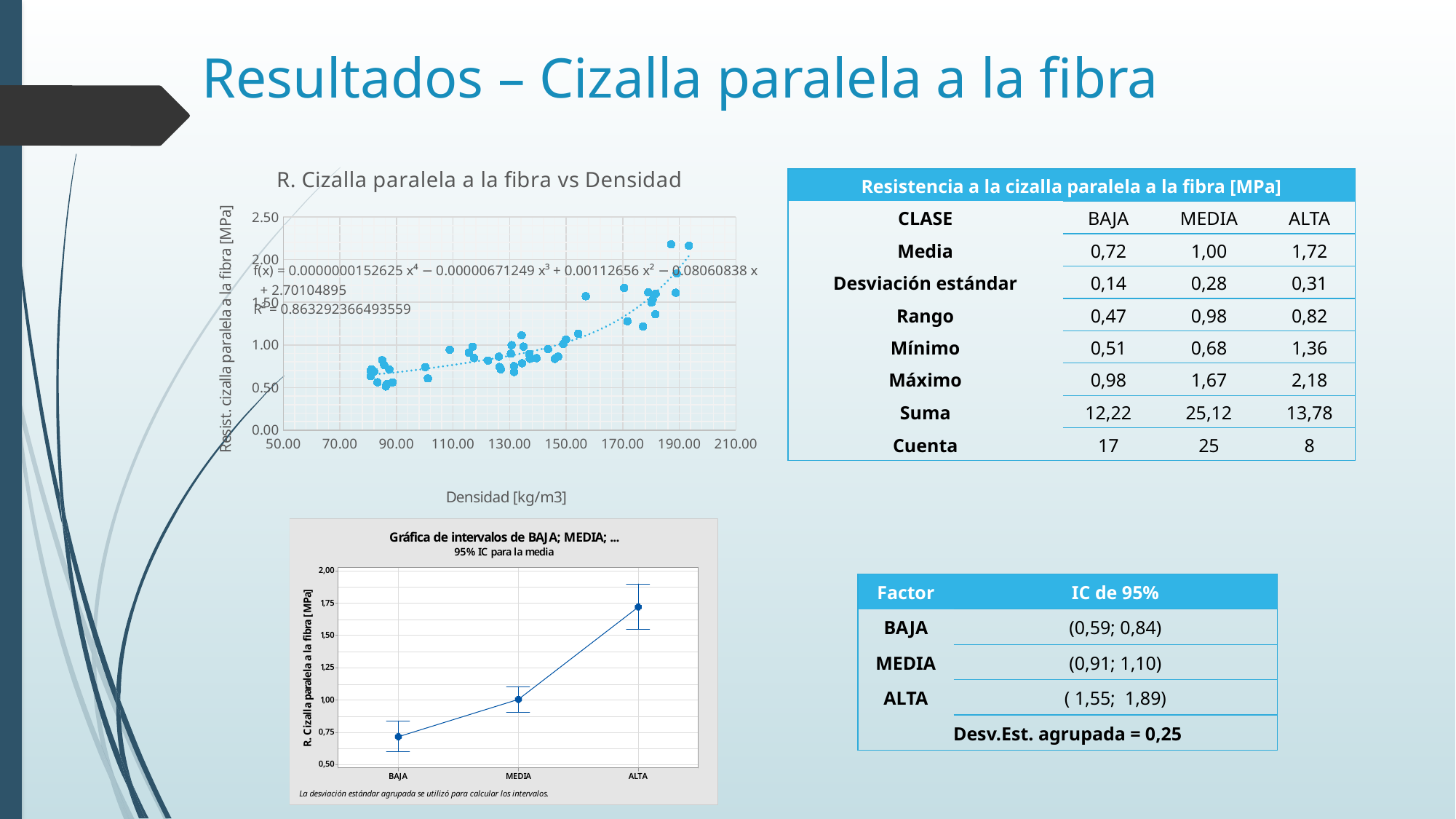
What is the R² value printed on the chart 'R. Cizalla paralela a la fibra vs Densidad'? 0.863292366493559 In the chart 'R. Cizalla paralela a la fibra vs Densidad', do the values generally rise or fall as density increases along the x axis? rise How many categories are shown on the x axis of the chart 'Gráfica de intervalos de BAJA; MEDIA; ...'? 3 In the chart 'R. Cizalla paralela a la fibra vs Densidad', what is the maximum value shown on the y axis? 2.50 In the chart 'Gráfica de intervalos de BAJA; MEDIA; ...', do the means rise or fall from BAJA to ALTA? rise What kind of chart is the chart titled 'R. Cizalla paralela a la fibra vs Densidad'? scatter chart In the chart 'Gráfica de intervalos de BAJA; MEDIA; ...', which category has the lowest mean? BAJA What is the x-axis label of the chart 'R. Cizalla paralela a la fibra vs Densidad'? Densidad [kg/m3] In the chart 'R. Cizalla paralela a la fibra vs Densidad', is the highest plotted point greater or less than 2.00? greater In the chart 'Gráfica de intervalos de BAJA; MEDIA; ...', is the mean for ALTA greater or less than 1,50? greater In the chart 'Gráfica de intervalos de BAJA; MEDIA; ...', which category has the highest mean? ALTA In the chart 'Gráfica de intervalos de BAJA; MEDIA; ...', is the mean for BAJA greater or less than 1,00? less